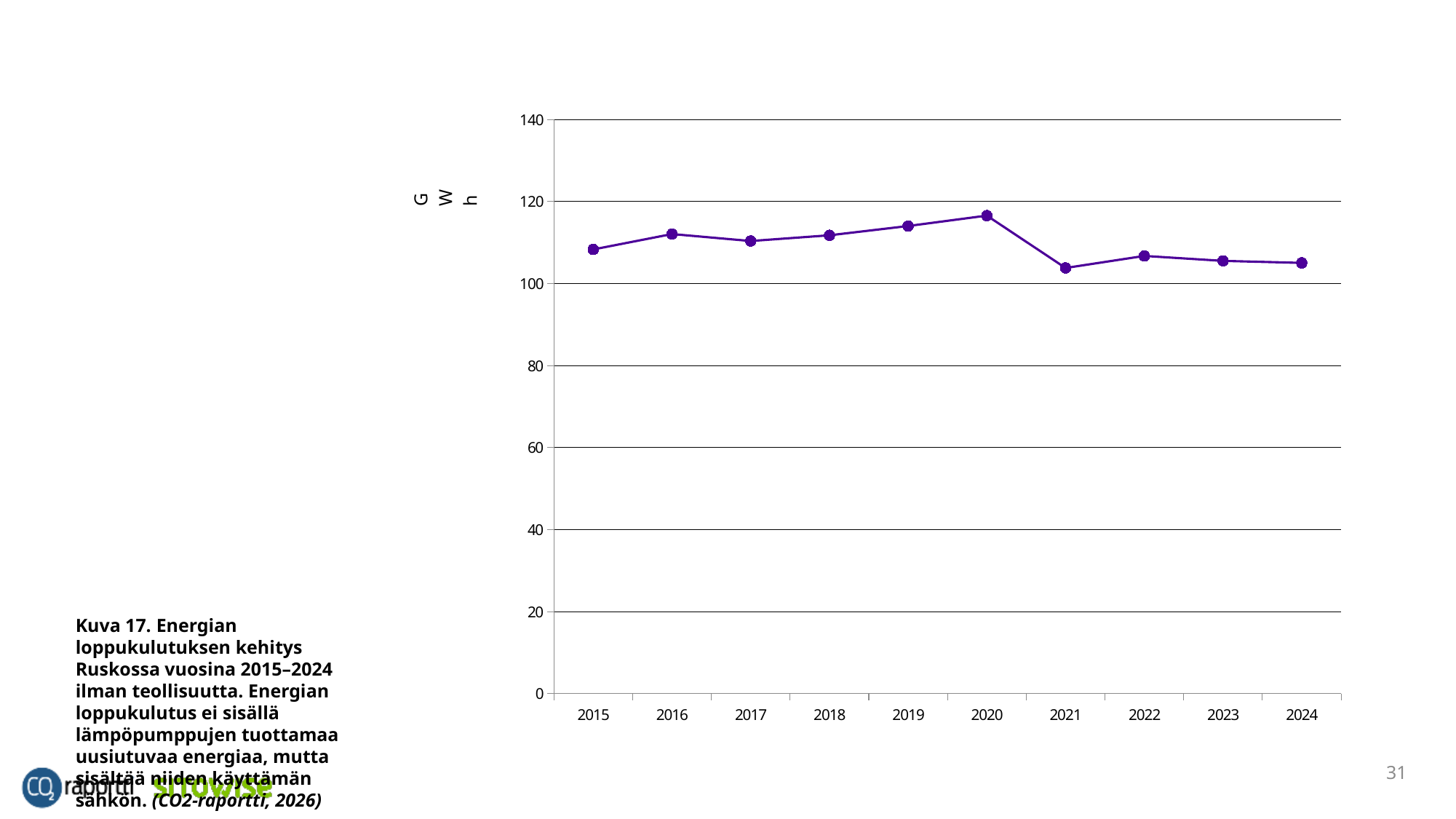
What unit is shown on the y axis of the chart? GWh What kind of chart is shown on the slide? line chart Is the value for 2020 greater or less than 120? less Is the value for 2021 greater or less than 100? greater Is the value for 2015 greater or less than 120? less Does the value rise or fall from 2020 to 2021? fall Which is larger, the value for 2019 or the value for 2024? 2019 How many years (data points) are plotted on the x axis? 10 Which is larger, the value for 2020 or the value for 2021? 2020 Which year has the highest value on the chart? 2020 What is the first year shown on the x axis? 2015